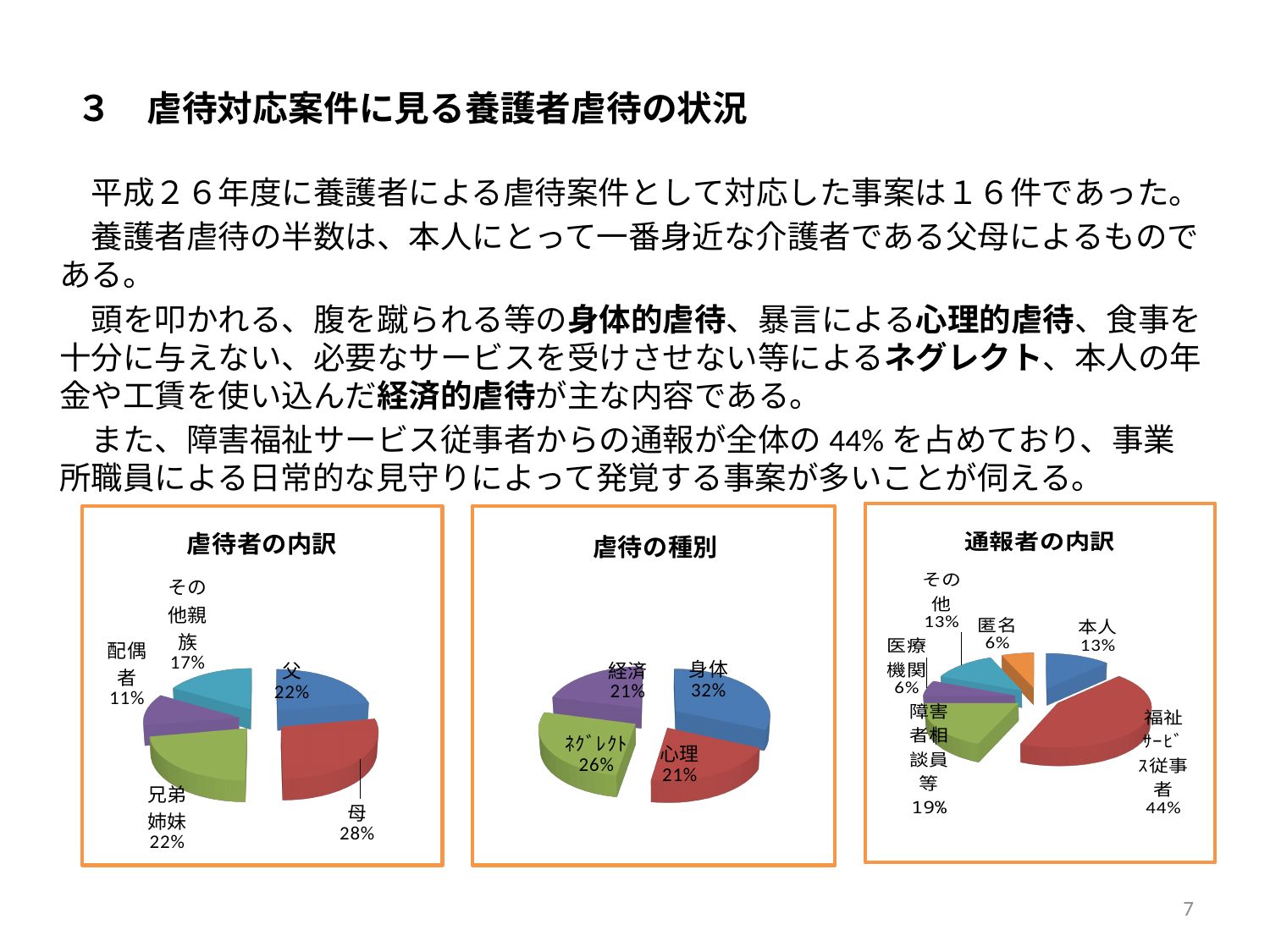
What type of chart is the chart titled 虐待の種別? Pie chart In the chart titled 虐待者の内訳, how many categories are shown? 5 In the chart titled 虐待者の内訳, what is the difference between the shares of 母 and 配偶者? 17% In the chart titled 虐待の種別, what percentage is shown for ネグレクト? 26% In the chart titled 通報者の内訳, what percentage is shown for 福祉サービス従事者? 44% In the chart titled 虐待の種別, how many categories are shown? 4 In the chart titled 通報者の内訳, what percentage is shown for 医療機関? 6% In the chart titled 通報者の内訳, which is larger, 障害者相談員等 or 本人? 障害者相談員等 In the chart titled 虐待者の内訳, which category has the smallest share? 配偶者 In the chart titled 虐待者の内訳, what percentage is shown for 母? 28% In the chart titled 通報者の内訳, how many categories are shown? 6 In the chart titled 虐待の種別, which category has the largest share? 身体